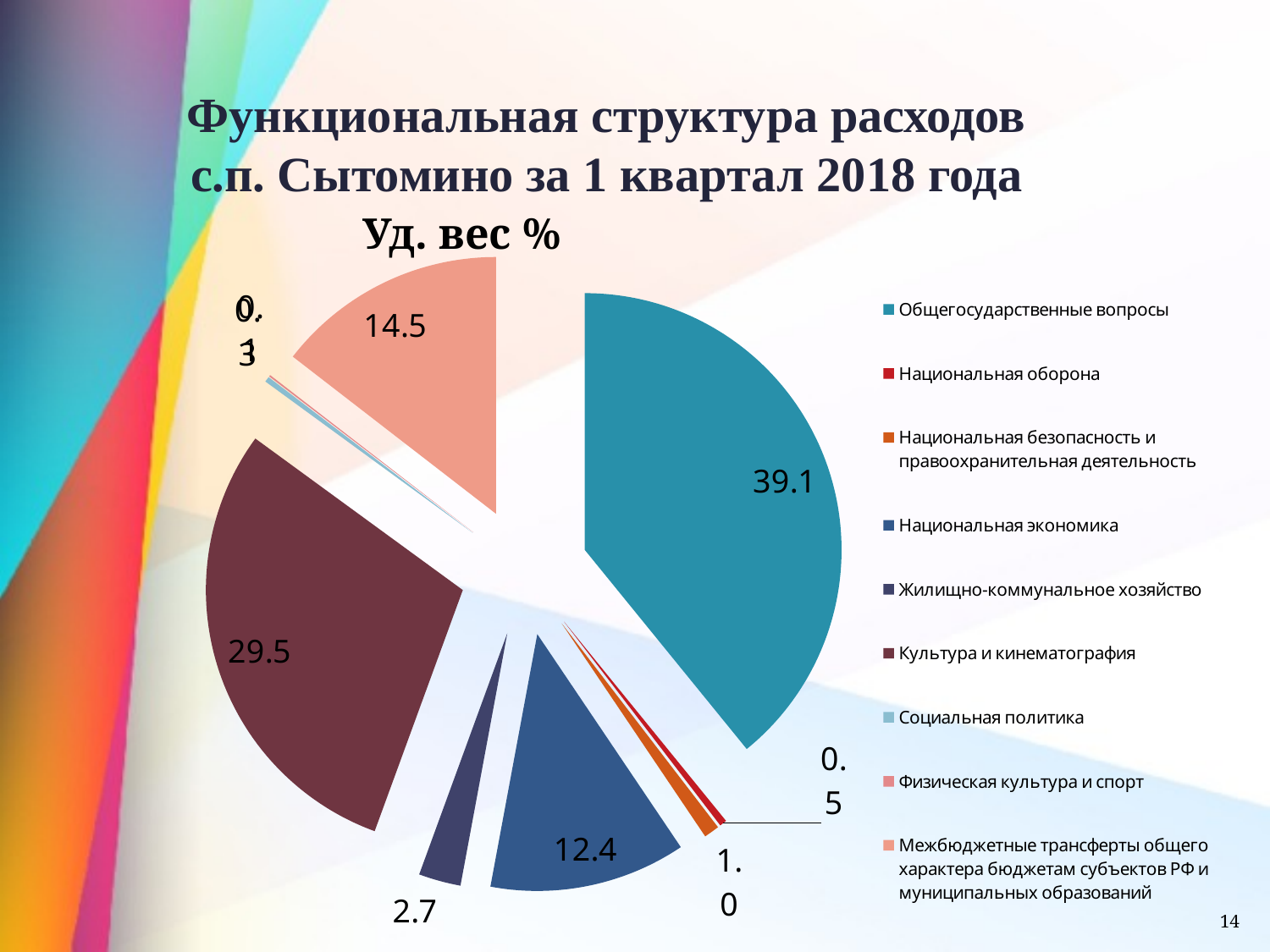
What is the value for Национальная экономика? 12.4 What is the difference between the values for Общегосударственные вопросы and Культура и кинематография? 9.6 Which category has the largest share of the pie? Общегосударственные вопросы Which is larger, the value for Национальная экономика or the value for Межбюджетные трансферты общего характера? Межбюджетные трансферты общего характера How many categories does the legend list? 9 What is the value for Жилищно-коммунальное хозяйство? 2.7 What is the value for Культура и кинематография? 29.5 What is the value for Общегосударственные вопросы? 39.1 What is the value for Межбюджетные трансферты общего характера бюджетам субъектов РФ и муниципальных образований? 14.5 What kind of chart is shown on the slide? pie chart What is the title of the chart? Уд. вес % What colour is the slice for Культура и кинематография? dark maroon